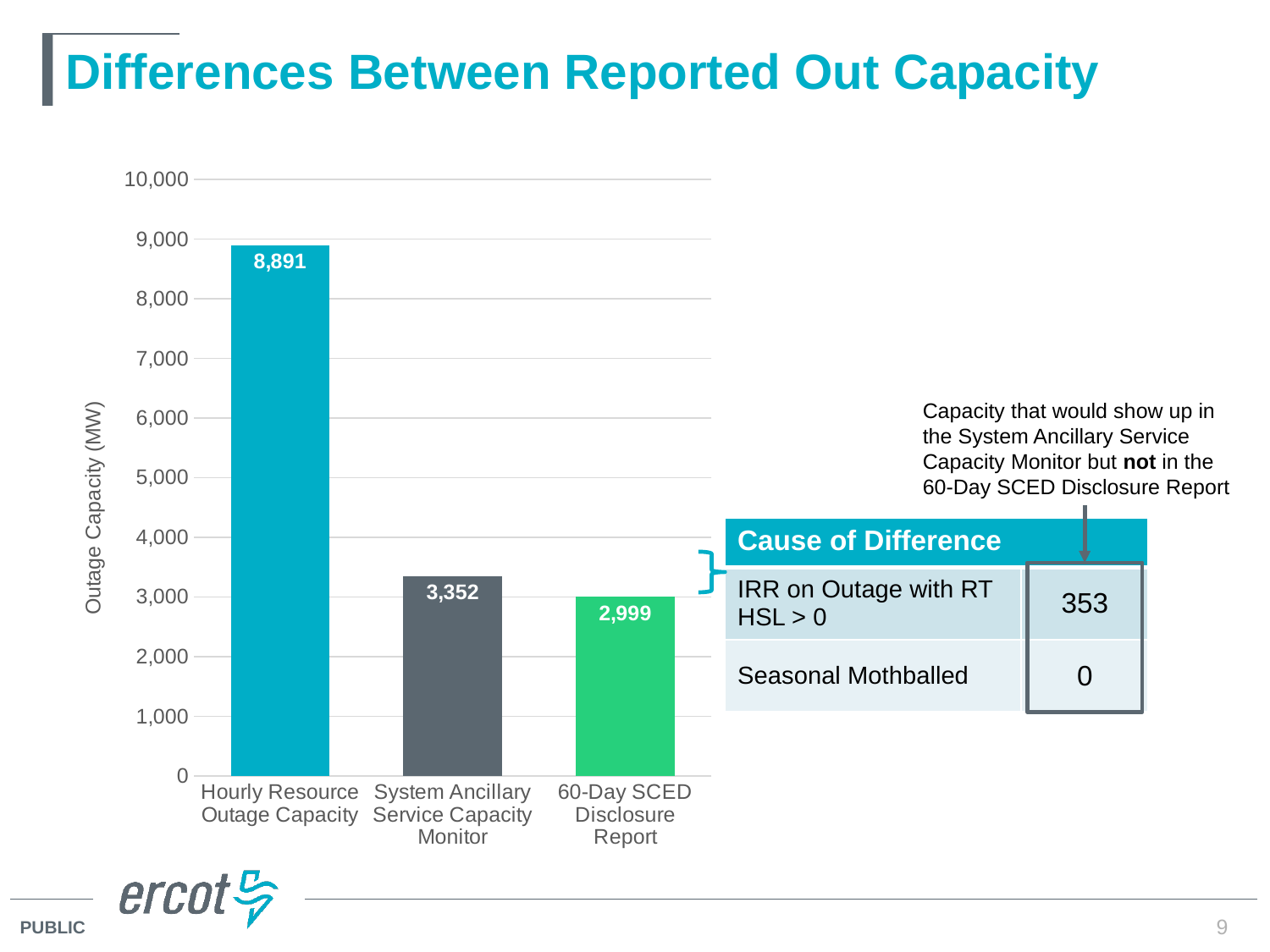
What is the label of the vertical axis? Outage Capacity (MW) What is the difference between the Hourly Resource Outage Capacity value and the System Ancillary Service Capacity Monitor value? 5,539 Which category has the lowest outage capacity? 60-Day SCED Disclosure Report What kind of chart is shown on the slide? bar chart What is the value for System Ancillary Service Capacity Monitor? 3,352 What is the value for Hourly Resource Outage Capacity? 8,891 Which category has the highest outage capacity? Hourly Resource Outage Capacity What is the value for 60-Day SCED Disclosure Report? 2,999 How many categories are shown in the chart? 3 Which is larger, the value for System Ancillary Service Capacity Monitor or the value for 60-Day SCED Disclosure Report? System Ancillary Service Capacity Monitor Is the value for Hourly Resource Outage Capacity greater or less than 8,000? greater What is the difference between the System Ancillary Service Capacity Monitor value and the 60-Day SCED Disclosure Report value? 353